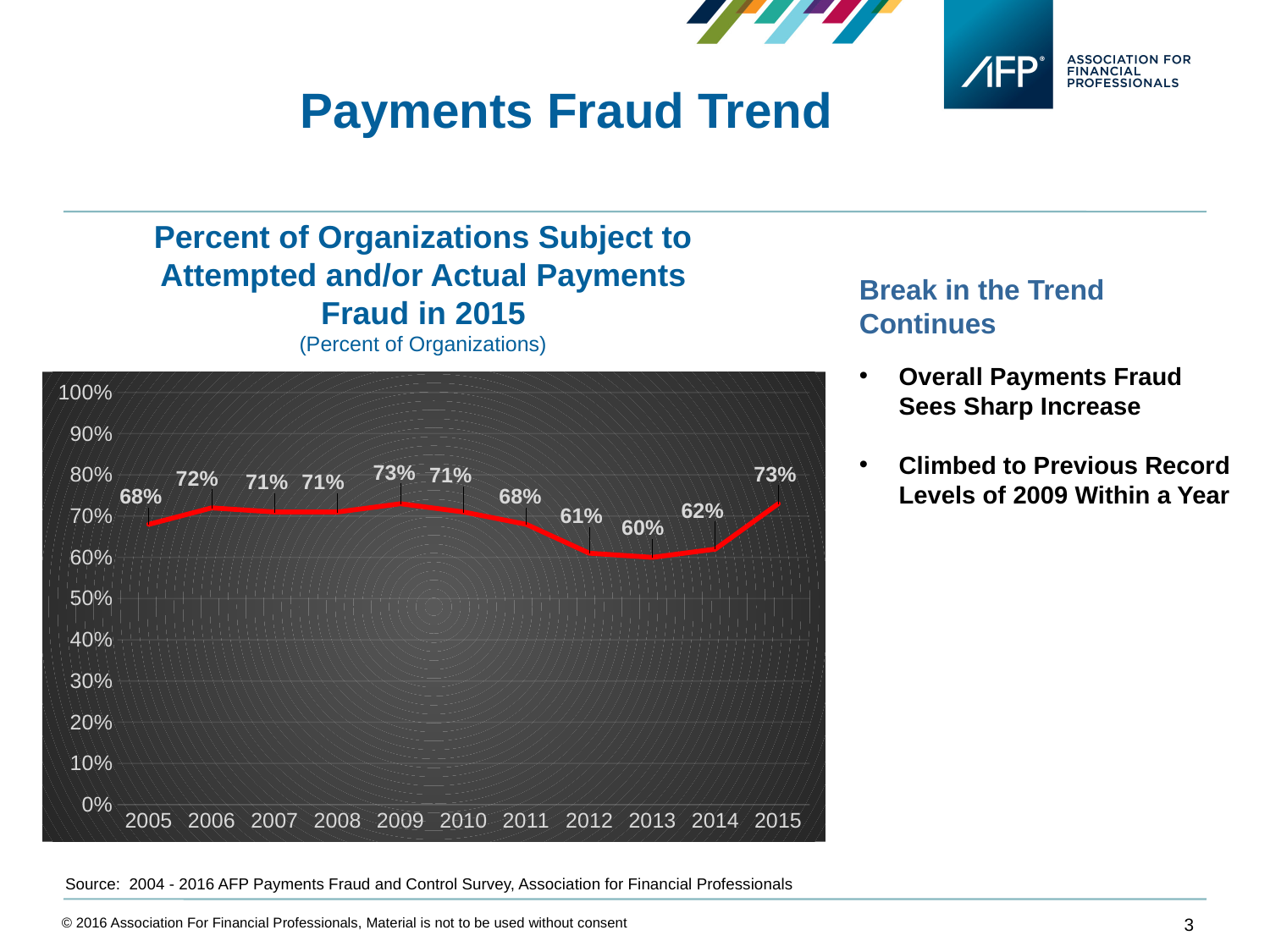
Which year has the lowest value? 2013 Is the value for 2010 greater or less than 60%? greater Do the values rise or fall from 2014 to 2015? rise What colour is the line on the chart? red How many years are plotted on the chart? 11 What is the difference between the values for 2009 and 2013? 13% What is the value for 2005? 68% What kind of chart is shown? line chart What is the value for 2013? 60% What is the value for 2015? 73% Which is larger, the value for 2006 or the value for 2012? 2006 What is the difference between the values for 2015 and 2014? 11%